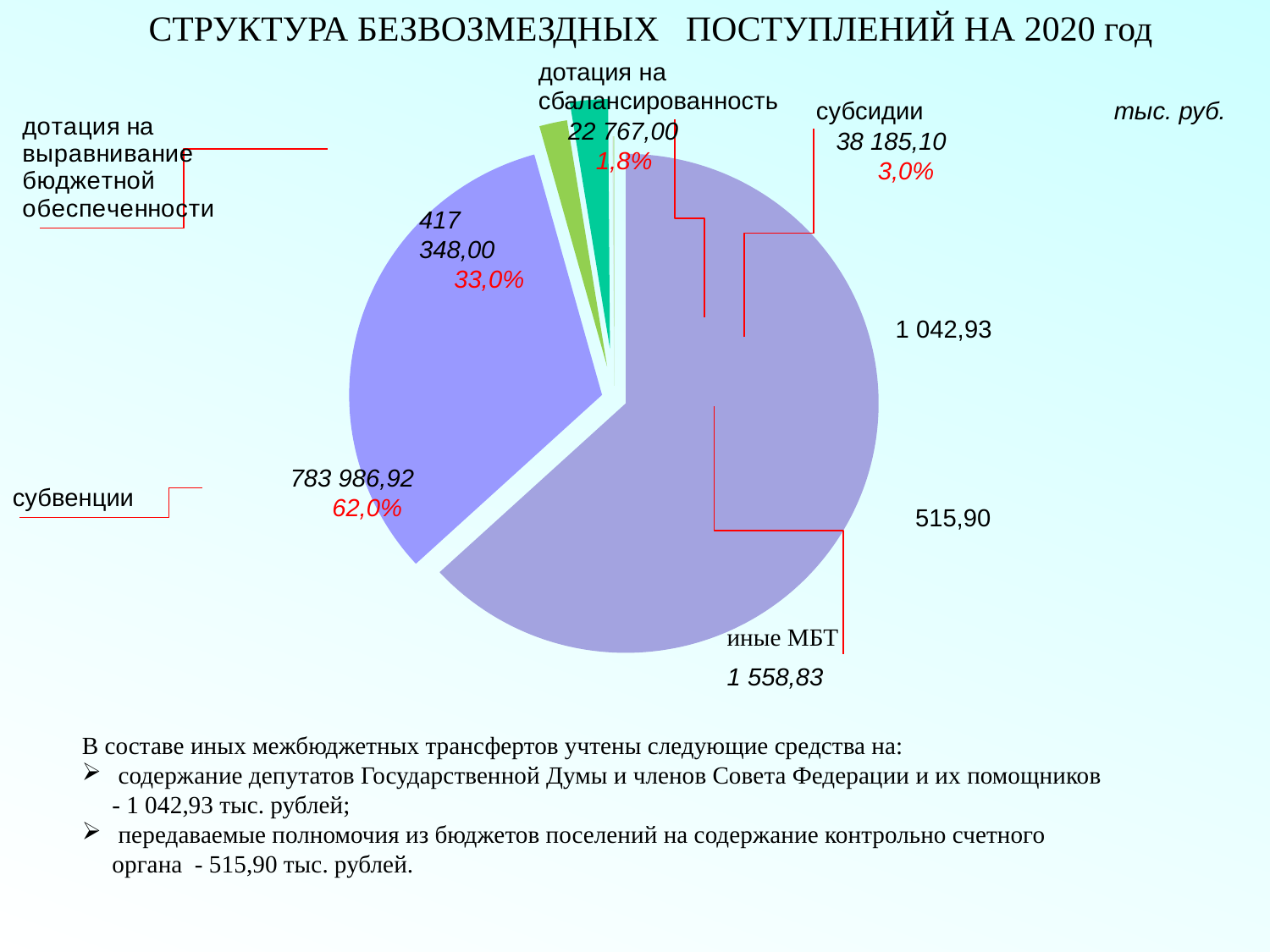
Which category has the smallest value in the pie chart? иные МБТ What is the difference between the values for субсидии and дотация на сбалансированность? 15 418,10 What percentage share is shown for дотация на выравнивание бюджетной обеспеченности? 33,0% What is the value for иные МБТ? 1 558,83 What is the value for дотация на выравнивание бюджетной обеспеченности? 417 348,00 What share of the pie do субвенции account for? 62,0% Which category has the largest share of the pie? субвенции What is the value for субсидии? 38 185,10 What type of chart is shown on the slide? pie chart In what units are the values on the chart given? тыс. руб. What is the value for субвенции in the pie chart? 783 986,92 What share of the pie is shown for дотация на сбалансированность? 1,8%